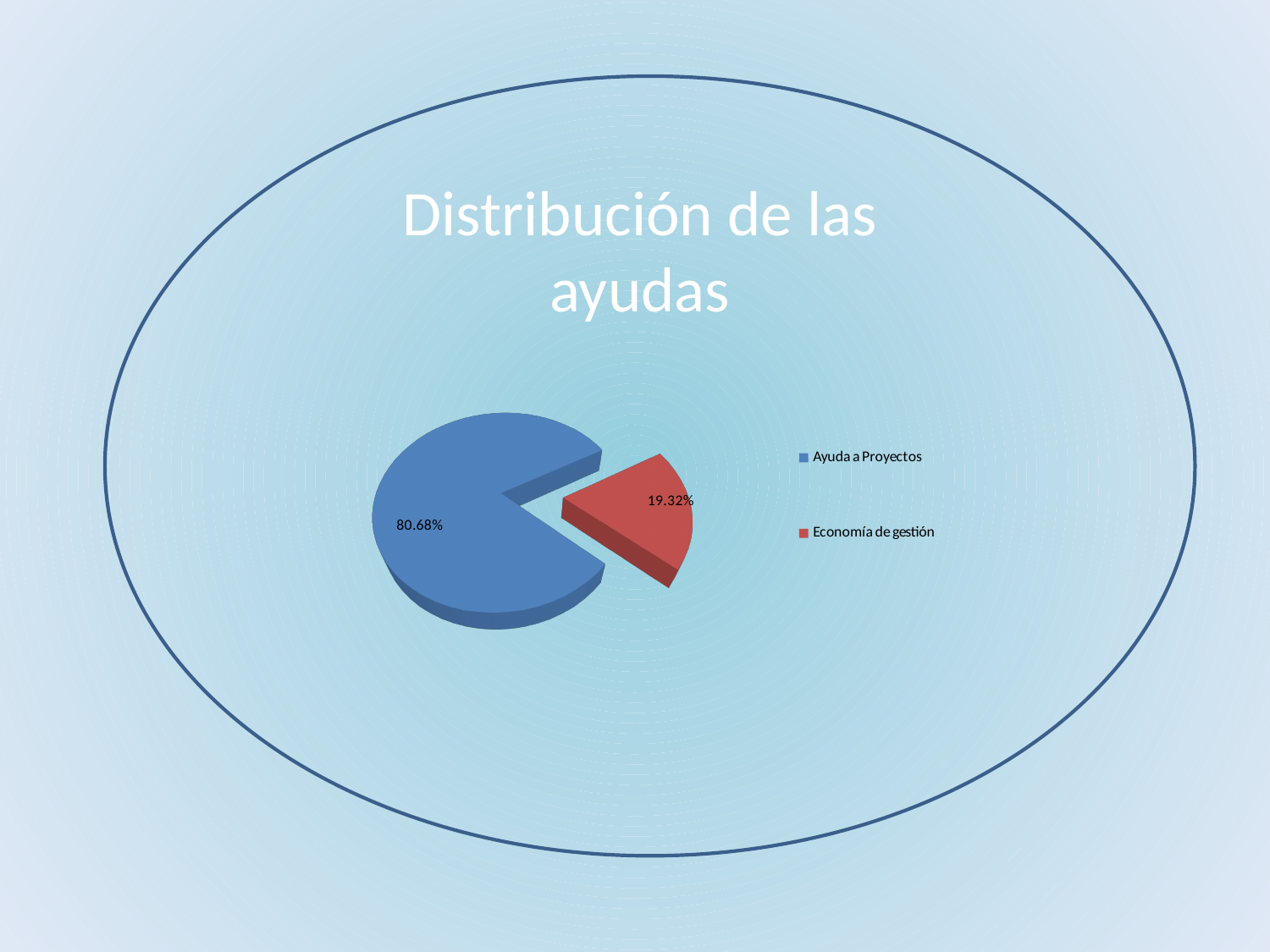
What is the value shown for Economía de gestión? 19.32% What is the difference between the shares of Ayuda a Proyectos and Economía de gestión? 61.36% Which is larger, the share for Ayuda a Proyectos or the share for Economía de gestión? Ayuda a Proyectos Which category has the largest share of the pie? Ayuda a Proyectos What is the title of the chart? Distribución de las ayudas How many entries does the legend list? 2 How many categories does the pie chart show? 2 What type of chart is shown on the slide? Pie chart What share of the pie does Economía de gestión represent? 19.32% Which category has the smallest share of the pie? Economía de gestión What colour is the slice for Economía de gestión? Red What is the value shown for Ayuda a Proyectos? 80.68%